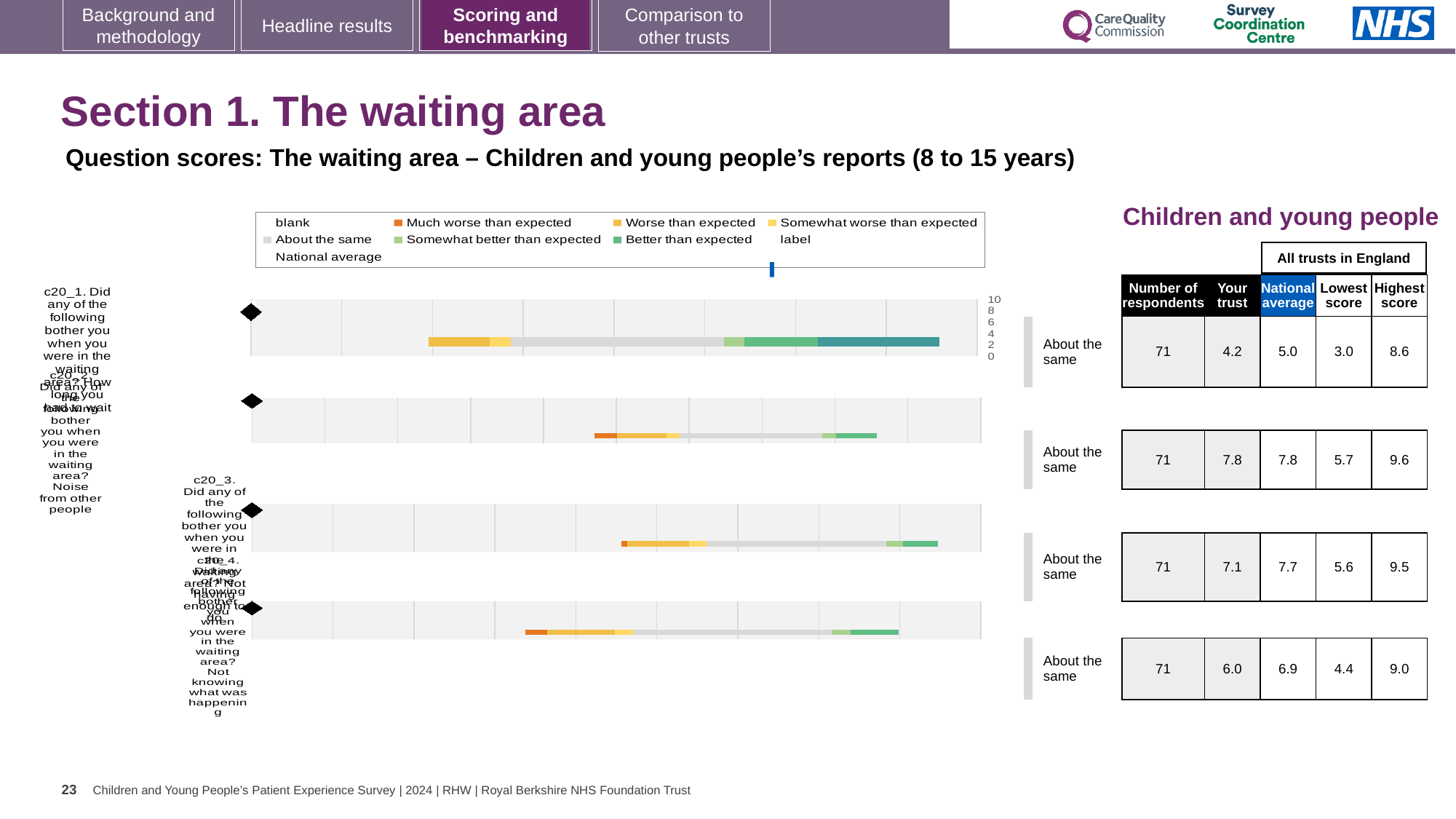
What is the lowest score across all trusts in England for the fourth question (c20_4, not knowing what was happening)? 4.4 What is the 'Your trust' score for the first question (c20_1, how long you had to wait)? 4.2 How many question bars are plotted in the chart? 4 For the third question (c20_3), which is larger: the 'Your trust' score or the national average? national average What is the title of the table to the right of the chart? Children and young people How many respondents answered each of the four waiting area questions? 71 What is the highest score across all trusts in England for the third question (c20_3, not having enough to do)? 9.5 Which question has the lowest 'Your trust' score? c20_1 (how long you had to wait) What is the national average score for the second question (c20_2, noise from other people)? 7.8 What kind of chart is used to show the question scores on this slide? bar chart Which question has the highest 'Your trust' score? c20_2 (noise from other people) In the chart legend, what colour represents 'Much worse than expected'? orange